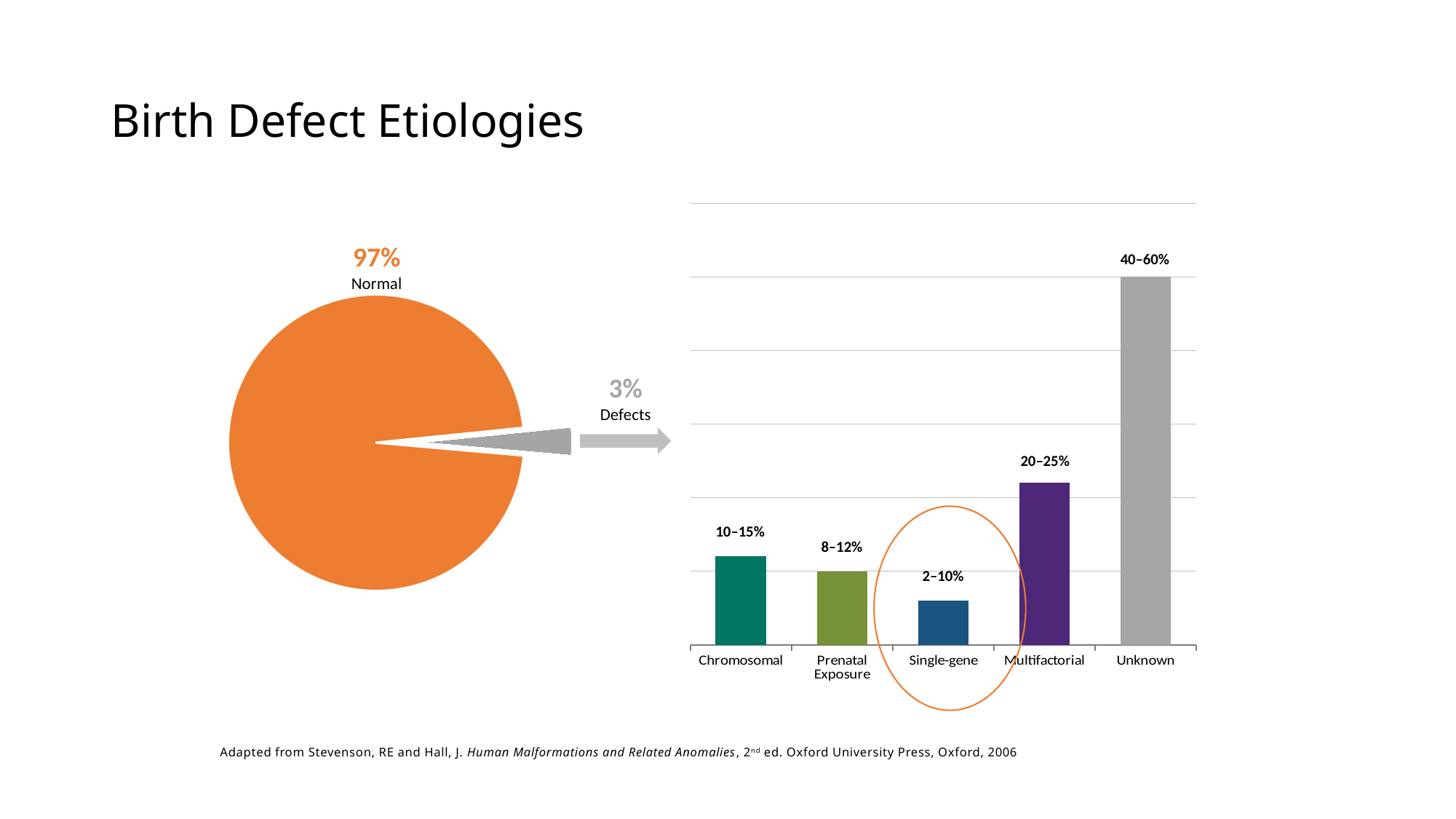
On the bar chart on the right, which bar is taller, Chromosomal or Prenatal Exposure? Chromosomal On the bar chart on the right, what is the value shown for Prenatal Exposure? 8–12% What kind of chart is on the left side of the slide? Pie chart On the pie chart on the left, what percentage is labelled Normal? 97% On the bar chart on the right, which category has the tallest bar? Unknown How many categories are shown on the bar chart on the right? 5 On the bar chart on the right, which category has the shortest bar? Single-gene On the pie chart on the left, what percentage is labelled Defects? 3% On the bar chart on the right, what is the value shown for Single-gene? 2–10% On the bar chart on the right, what is the value shown for Multifactorial? 20–25% On the bar chart on the right, which category is circled in orange? Single-gene On the bar chart on the right, what is the value shown for Unknown? 40–60%